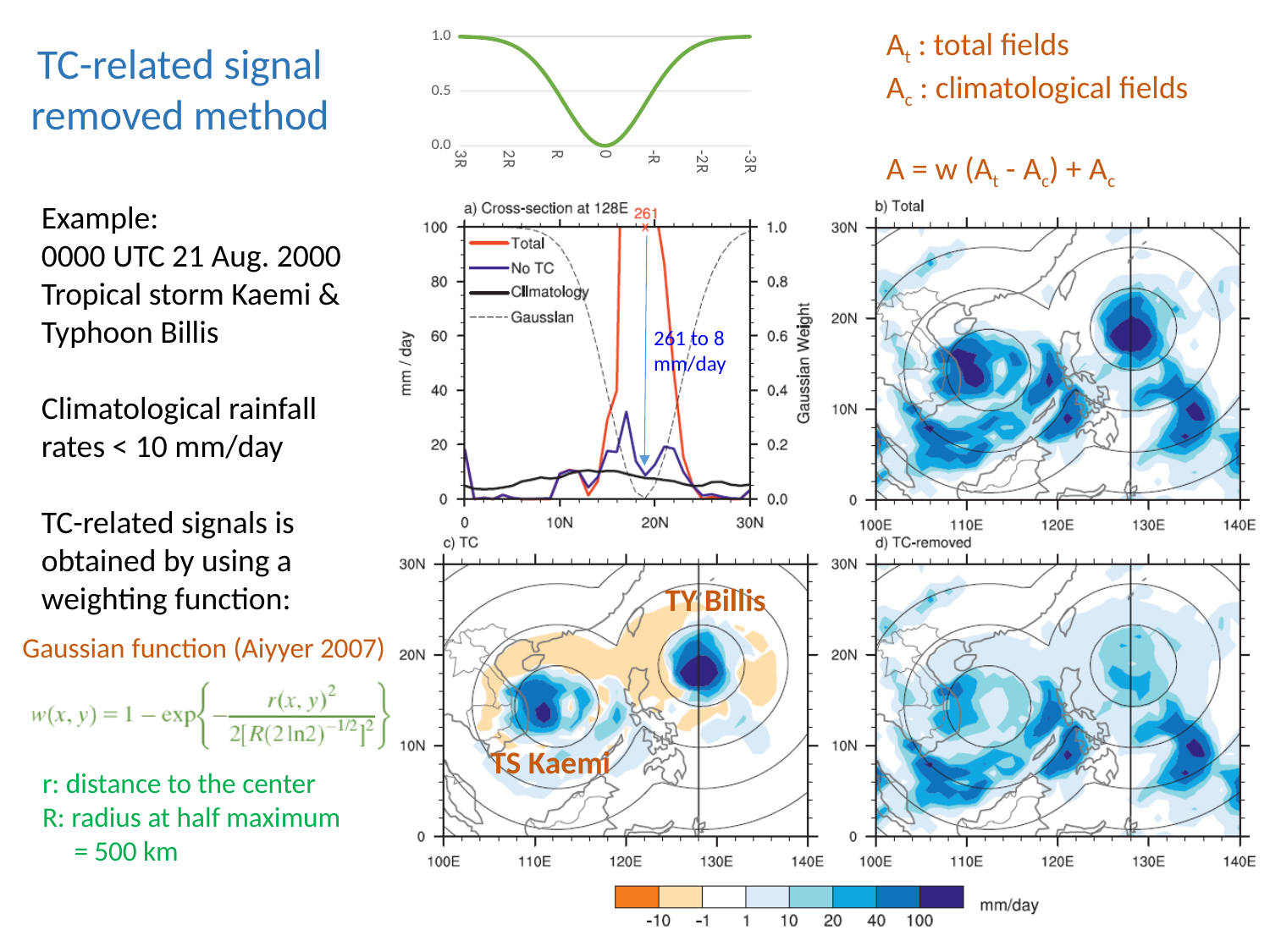
In the top-centre line chart, what is the value of the curve at x = 0? 0.0 In the chart titled 'a) Cross-section at 128E', what is the label of the right-hand y axis? Gaussian Weight What unit is shown next to the colour bar at the bottom of the slide? mm/day In the top-centre line chart, does the curve rise or fall as x goes from 3R to 0? fall What kind of chart is the small chart at the top centre of the slide with x-axis labels 3R to -3R? line chart In the chart titled 'a) Cross-section at 128E', how many series does the legend list? 4 In the chart titled 'a) Cross-section at 128E', what peak value is printed above the Total curve? 261 In the chart titled 'a) Cross-section at 128E', which series reaches the highest value? Total How many x-axis tick labels does the top-centre line chart show? 7 In the chart titled 'a) Cross-section at 128E', is the Climatology value at 20N greater or less than 20 mm/day? less In the top-centre line chart, at which x-axis label does the curve reach its lowest value? 0